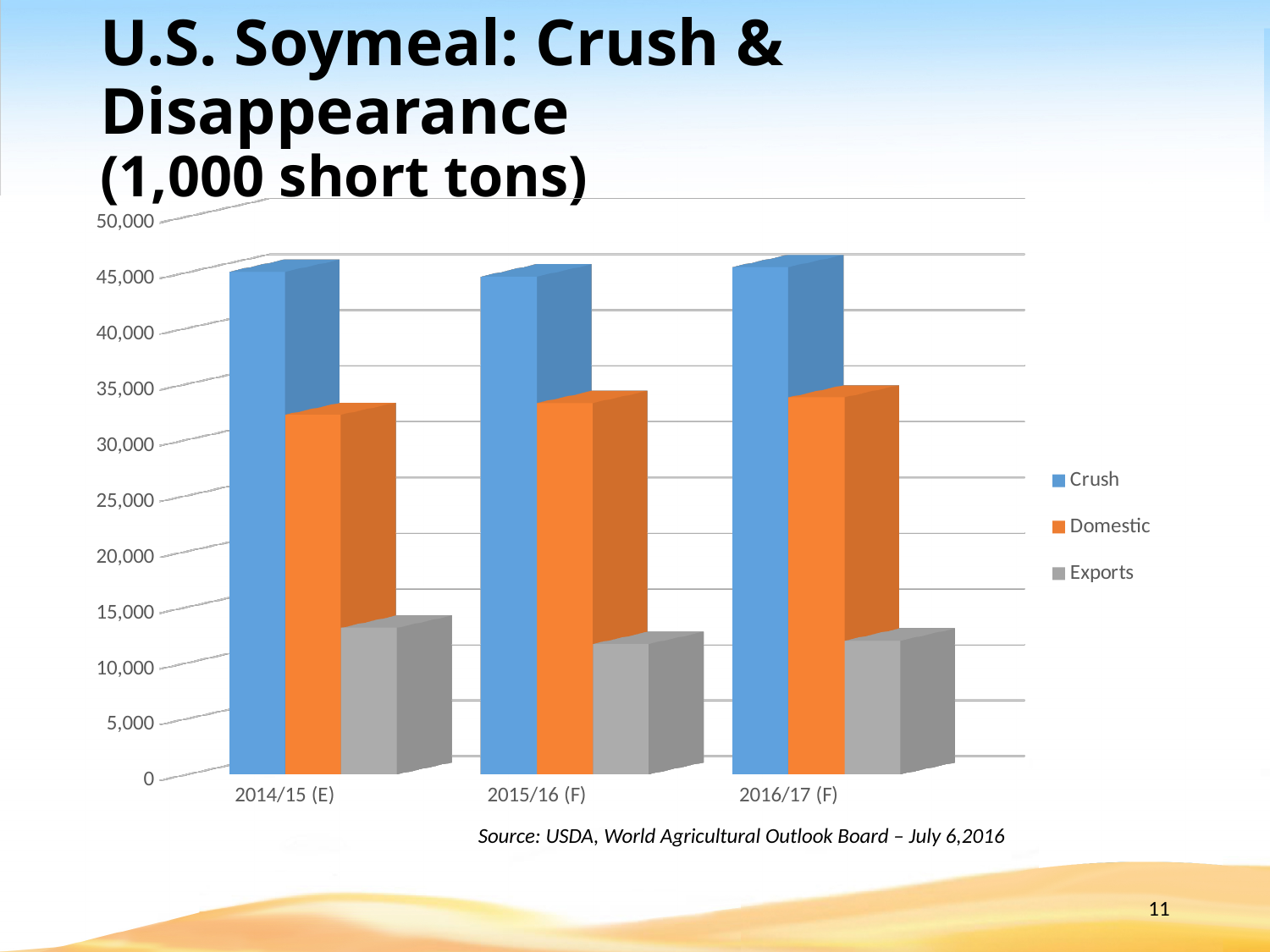
Is the Exports value for 2015/16 (F) greater or less than 15,000? less How many series does the legend list? 3 Does the Domestic series rise or fall from 2014/15 (E) to 2016/17 (F)? rise Which series has the highest value in 2014/15 (E)? Crush Is the Exports value for 2014/15 (E) greater or less than 10,000? greater How many marketing years are shown on the x axis? 3 What unit is given in the chart title? 1,000 short tons What kind of chart is shown on the slide? bar chart Which series has the lowest value in 2016/17 (F)? Exports Is the Crush value for 2014/15 (E) greater or less than 40,000? greater In 2015/16 (F), which is larger: Domestic or Exports? Domestic